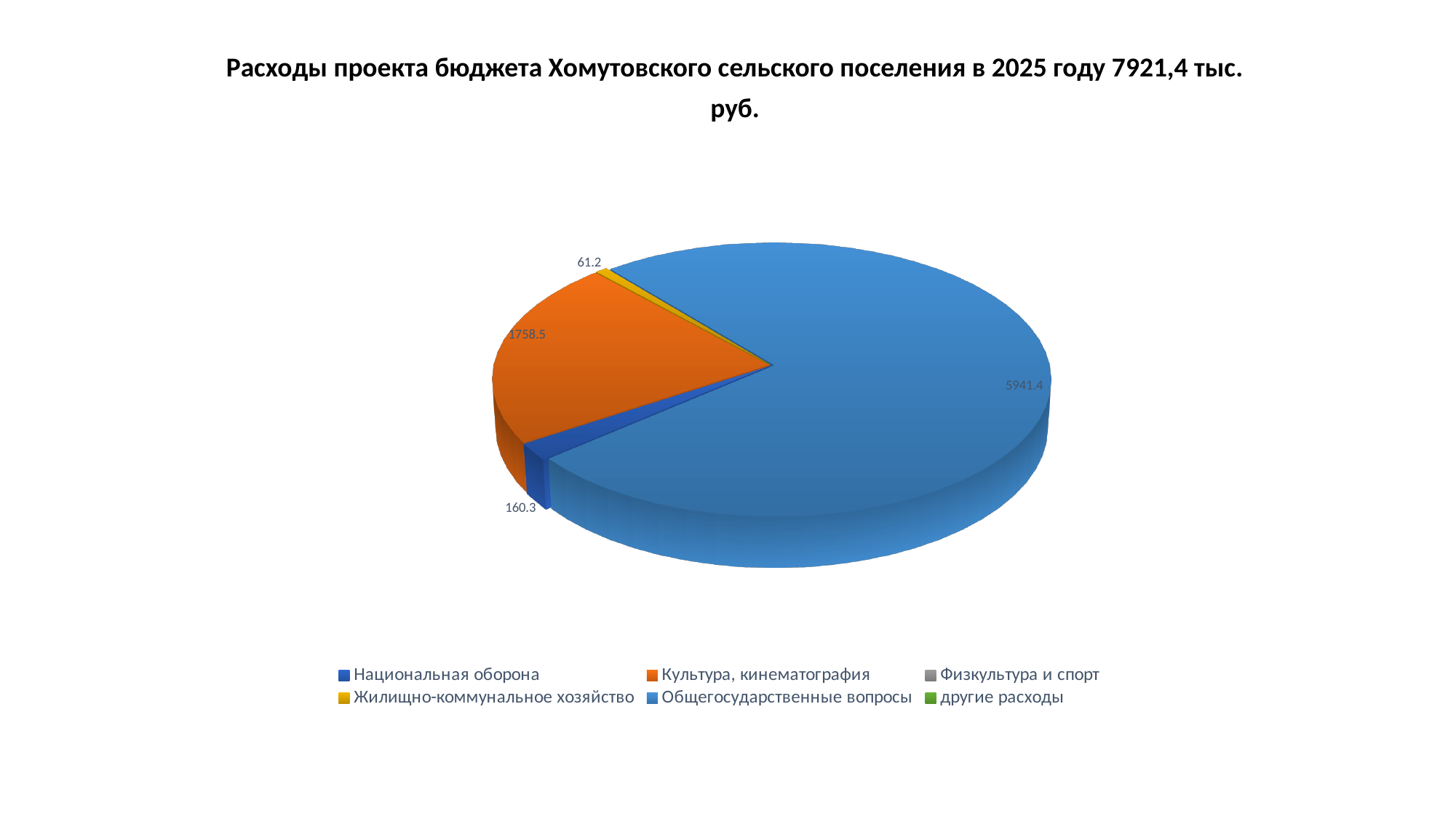
What is the value for Культура, кинематография? 1758.5 How many entries does the legend list? 6 Which of the labelled slices has the smallest value? Жилищно-коммунальное хозяйство What is the value for Национальная оборона? 160.3 What is the difference between the values for Общегосударственные вопросы and Культура, кинематография? 4182.9 How many slices have a data label printed on the chart? 4 What total expenditure amount is stated in the chart title? 7921,4 тыс. руб. Which category has the largest slice of the pie? Общегосударственные вопросы What is the value for Общегосударственные вопросы? 5941.4 What is the value for Жилищно-коммунальное хозяйство? 61.2 What type of chart is shown on the slide? pie chart Which is larger: Культура, кинематография or Национальная оборона? Культура, кинематография